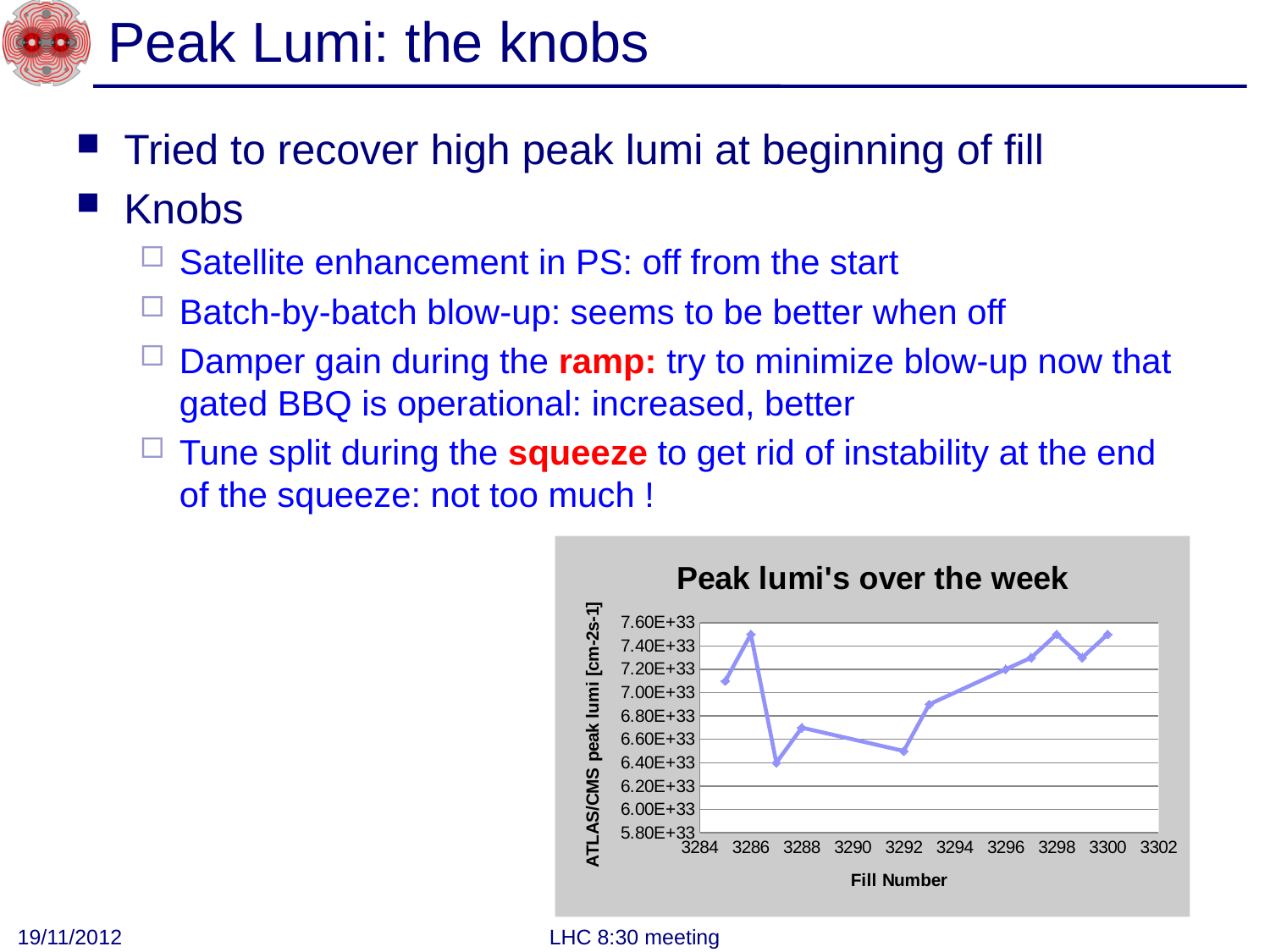
Is the peak lumi for fill 3286 greater or less than 7.40E+33? greater What is the label of the x axis of the chart? Fill Number Between fill 3292 and fill 3298, do the peak lumi values rise or fall? rise Which fill number has the lowest peak lumi in the chart? 3287 Which has the higher peak lumi, fill 3298 or fill 3299? 3298 Is the peak lumi for fill 3287 greater or less than 6.60E+33? less Is the peak lumi for fill 3296 greater or less than 7.00E+33? greater How many data points are plotted in the chart? 11 What kind of chart is "Peak lumi's over the week"? line chart Which has the higher peak lumi, fill 3286 or fill 3287? 3286 What is the title of the chart on the slide? Peak lumi's over the week